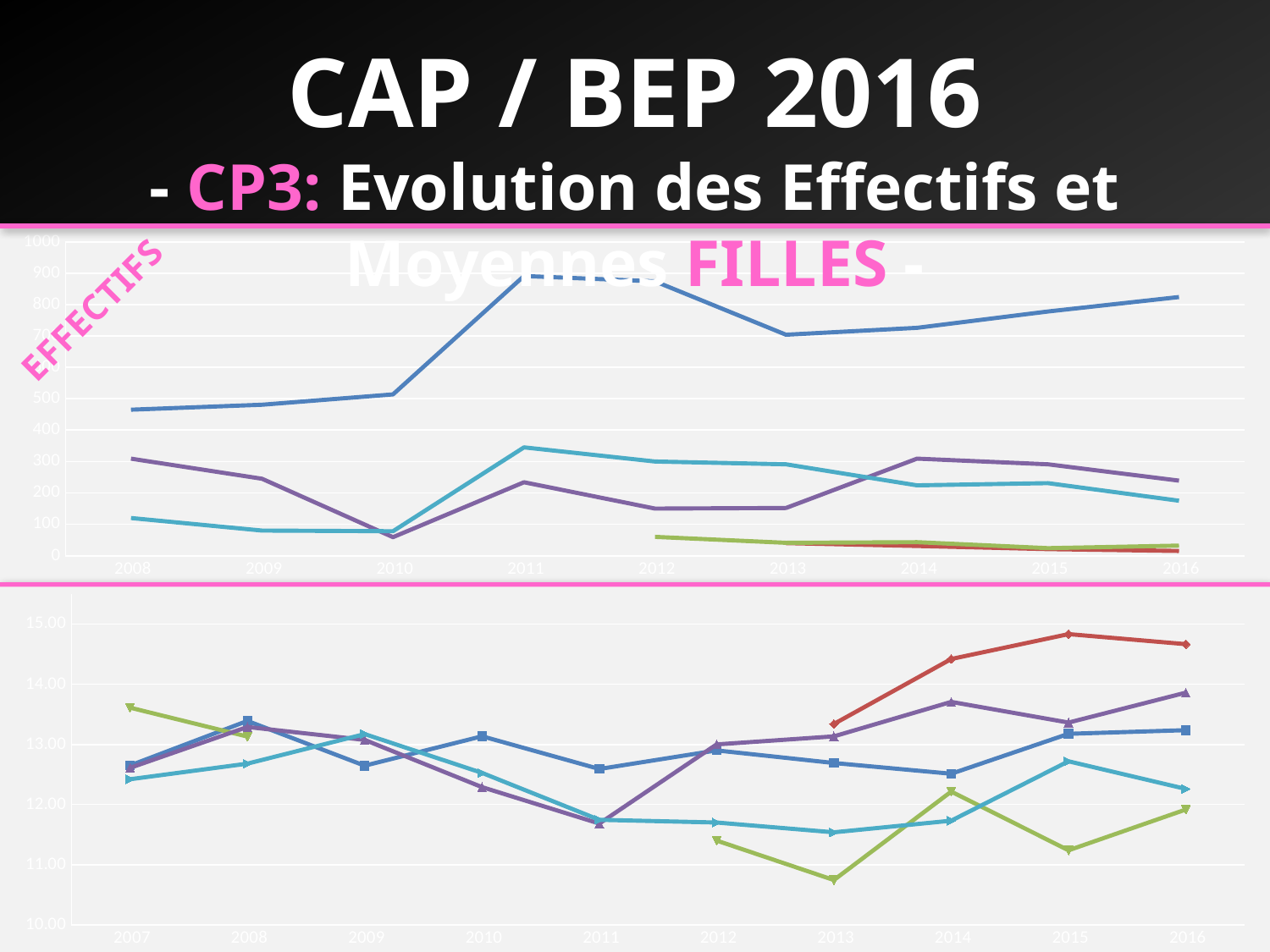
In the top chart (EFFECTIFS), is the value of the blue line in 2011 greater or less than 800? greater In the top chart (EFFECTIFS), which line is higher in 2011, the blue line or the teal line? the blue line How many years are shown on the x axis of the top chart (EFFECTIFS)? 9 How many years are shown on the x axis of the bottom chart? 10 In the top chart (EFFECTIFS), does the blue line rise or fall between 2013 and 2016? rise In the bottom chart, is the value of the green line in 2013 greater or less than 11.00? less In the bottom chart, is the value of the red line in 2015 greater or less than 14.00? greater In the top chart (EFFECTIFS), in which year does the blue line reach its highest value? 2011 What kind of chart is the top chart (EFFECTIFS)? line chart In the bottom chart, which line is higher in 2016, the red line or the green line? the red line In the bottom chart, in which year does the red line reach its highest value? 2015